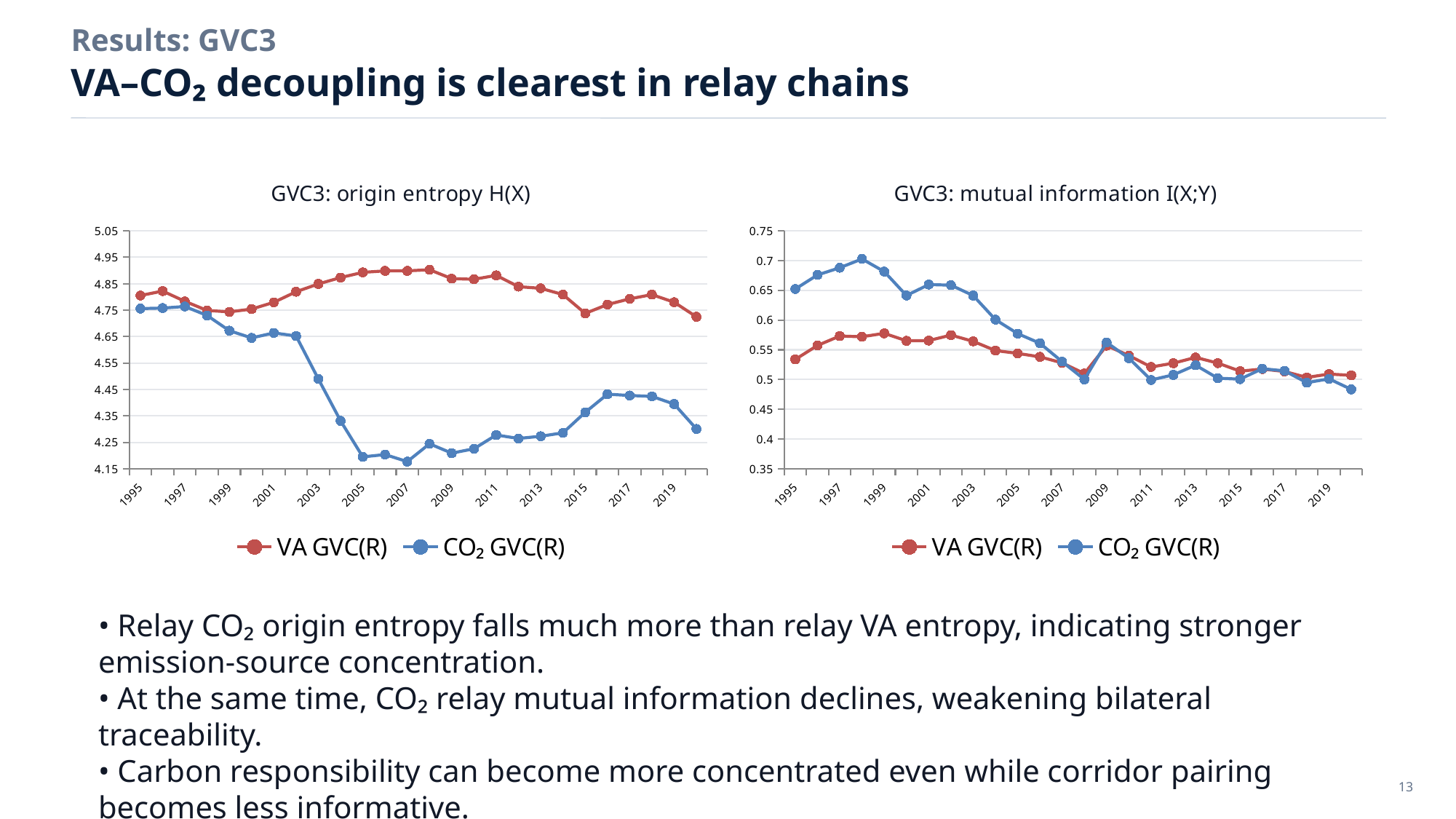
In the 'GVC3: origin entropy H(X)' chart, is the value for CO₂ GVC(R) in 2005 greater or less than 4.25? less In the 'GVC3: origin entropy H(X)' chart, which series has the higher value in 2010, VA GVC(R) or CO₂ GVC(R)? VA GVC(R) In the 'GVC3: origin entropy H(X)' chart, which series is plotted in blue? CO₂ GVC(R) In the 'GVC3: origin entropy H(X)' chart, is the value for VA GVC(R) in 2008 greater or less than 4.85? greater How many series does the legend of the 'GVC3: mutual information I(X;Y)' chart list? 2 In the 'GVC3: mutual information I(X;Y)' chart, in which year does CO₂ GVC(R) reach its highest value? 1998 What kind of chart is the 'GVC3: origin entropy H(X)' chart? line chart In the 'GVC3: mutual information I(X;Y)' chart, which series has the higher value in 1998, VA GVC(R) or CO₂ GVC(R)? CO₂ GVC(R) What is the title of the right-hand chart on the slide? GVC3: mutual information I(X;Y) In the 'GVC3: origin entropy H(X)' chart, does the CO₂ GVC(R) series overall rise or fall from 1995 to 2020? fall In the 'GVC3: mutual information I(X;Y)' chart, is the value for CO₂ GVC(R) in 2020 greater or less than 0.5? less